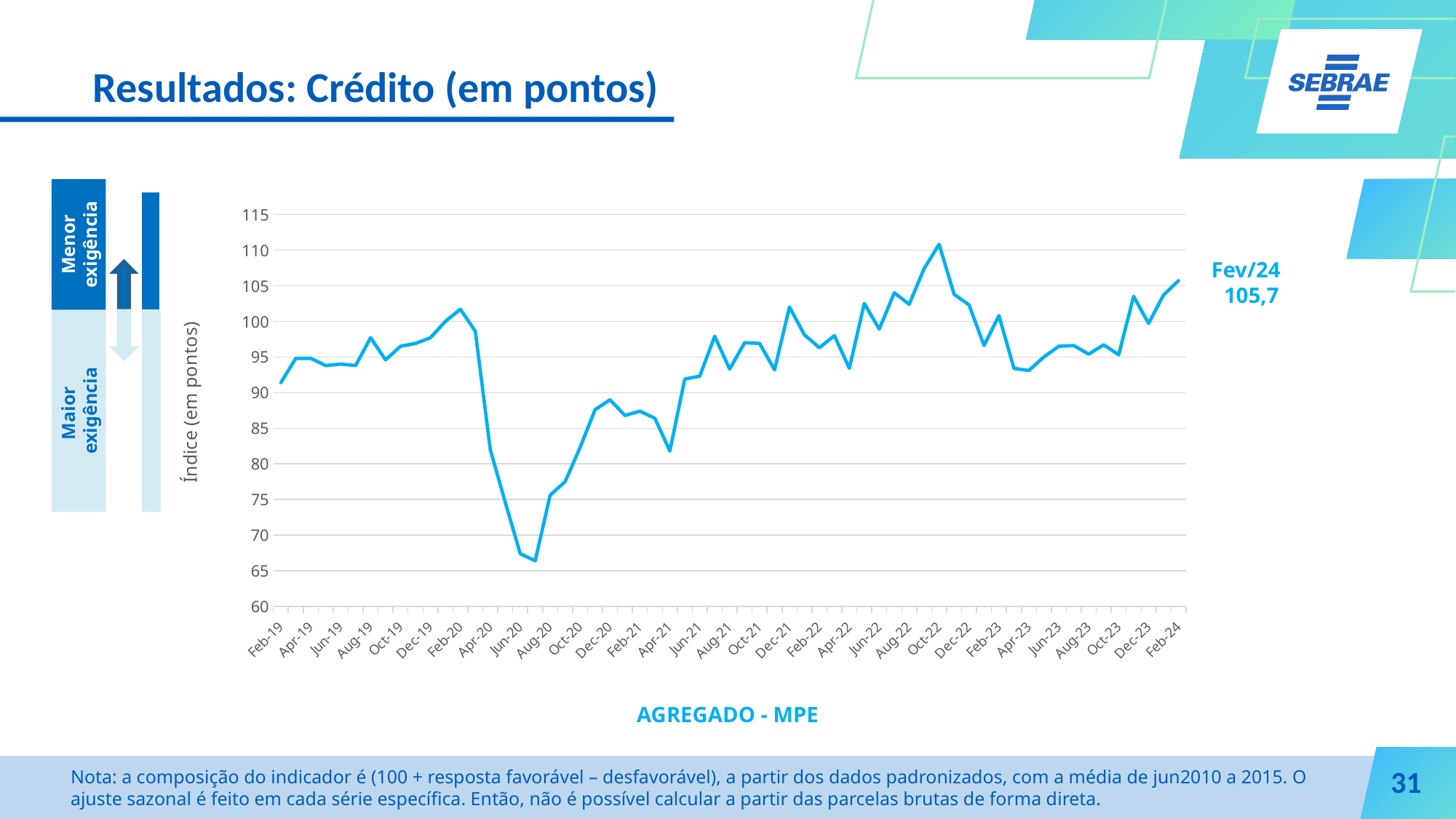
Which labeled month has the highest value on the chart? Oct-22 Is the value for Feb-19 greater or less than 95? less What is the title of the vertical axis? Índice (em pontos) What is the value of the index for Feb-24 (Fev/24)? 105,7 Which is larger, the value for Apr-21 or the value for Jun-21? Jun-21 Which is larger, the value for Feb-19 or the value for Feb-24? Feb-24 Is the value for Apr-23 greater or less than 95? less Is the value for Jun-20 greater or less than 70? less How many series are plotted on the chart? 1 Between Feb-20 and Jun-20, does the index rise or fall? fall What kind of chart is shown on the slide? line chart